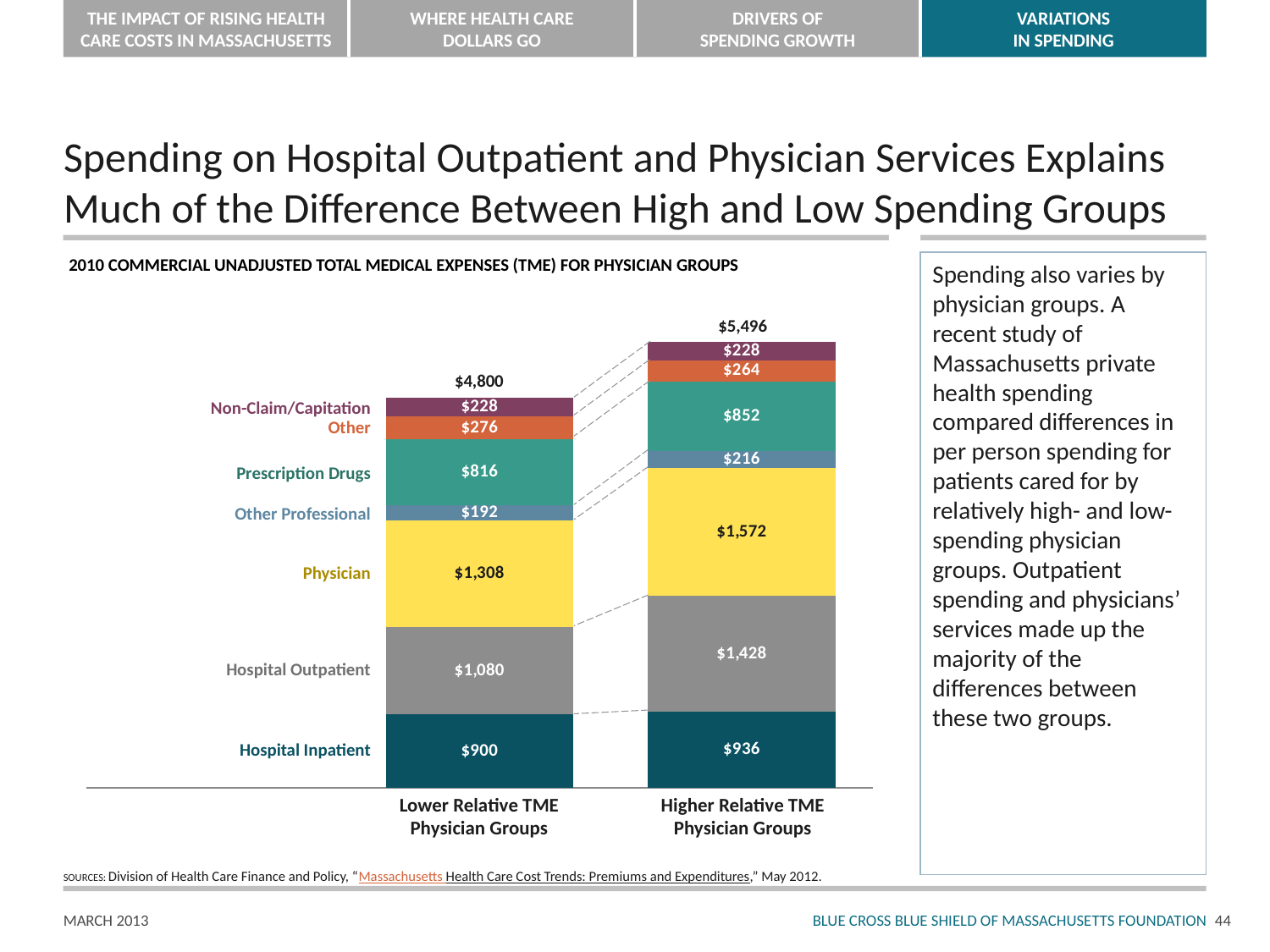
Which spending category is the largest segment in the Lower Relative TME Physician Groups bar? Physician What is the Non-Claim/Capitation value for the Lower Relative TME Physician Groups? $228 How many spending categories are stacked in each bar? 7 Which spending category is the smallest segment in the Higher Relative TME Physician Groups bar? Other Professional What is the difference in Physician spending between the Higher and Lower Relative TME Physician Groups? $264 What is the Hospital Outpatient spending for the Lower Relative TME Physician Groups? $1,080 What is the total medical expense shown for the Higher Relative TME Physician Groups bar? $5,496 What is the difference in Hospital Outpatient spending between the Higher and Lower Relative TME Physician Groups? $348 Is Other spending larger for the Lower or the Higher Relative TME Physician Groups? Lower Relative TME Physician Groups What is the total medical expense shown for the Lower Relative TME Physician Groups bar? $4,800 What type of chart is shown on the slide? Stacked bar chart What is the Physician spending for the Higher Relative TME Physician Groups? $1,572